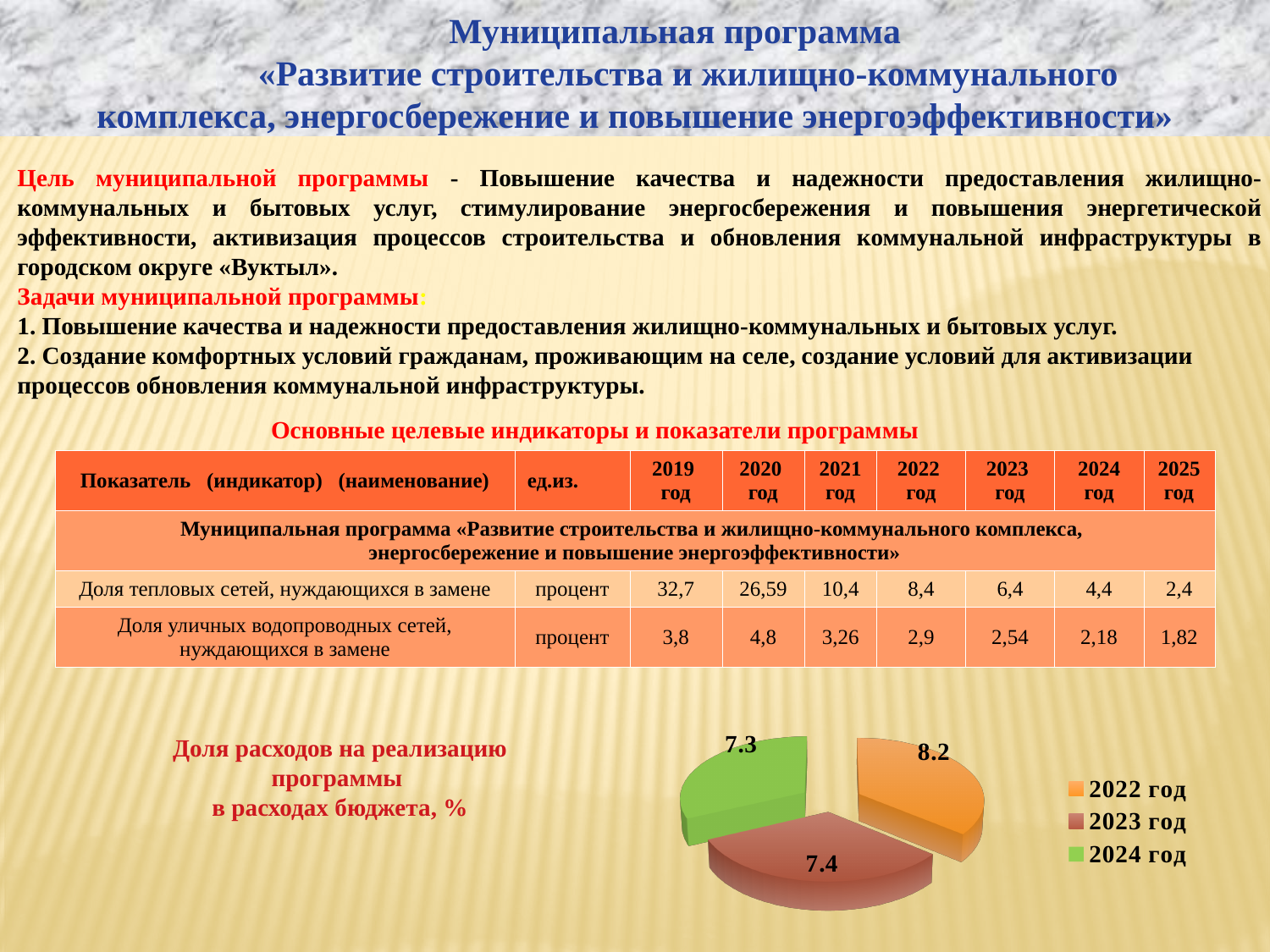
What value does the pie chart show for 2022 год? 8.2 In the pie chart, which is larger: the value for 2022 год or for 2024 год? 2022 год How many slices does the pie chart have? 3 How many entries does the legend of the pie chart list? 3 What value does the pie chart show for 2023 год? 7.4 Which year has the smallest slice in the pie chart? 2024 год What value does the pie chart show for 2024 год? 7.3 What is the difference between the values for 2022 год and 2024 год in the pie chart? 0.9 Which year has the largest slice in the pie chart? 2022 год What is the difference between the values for 2022 год and 2023 год in the pie chart? 0.8 What colour is the slice for 2024 год in the pie chart? Green What kind of chart is shown at the bottom of the slide? Pie chart